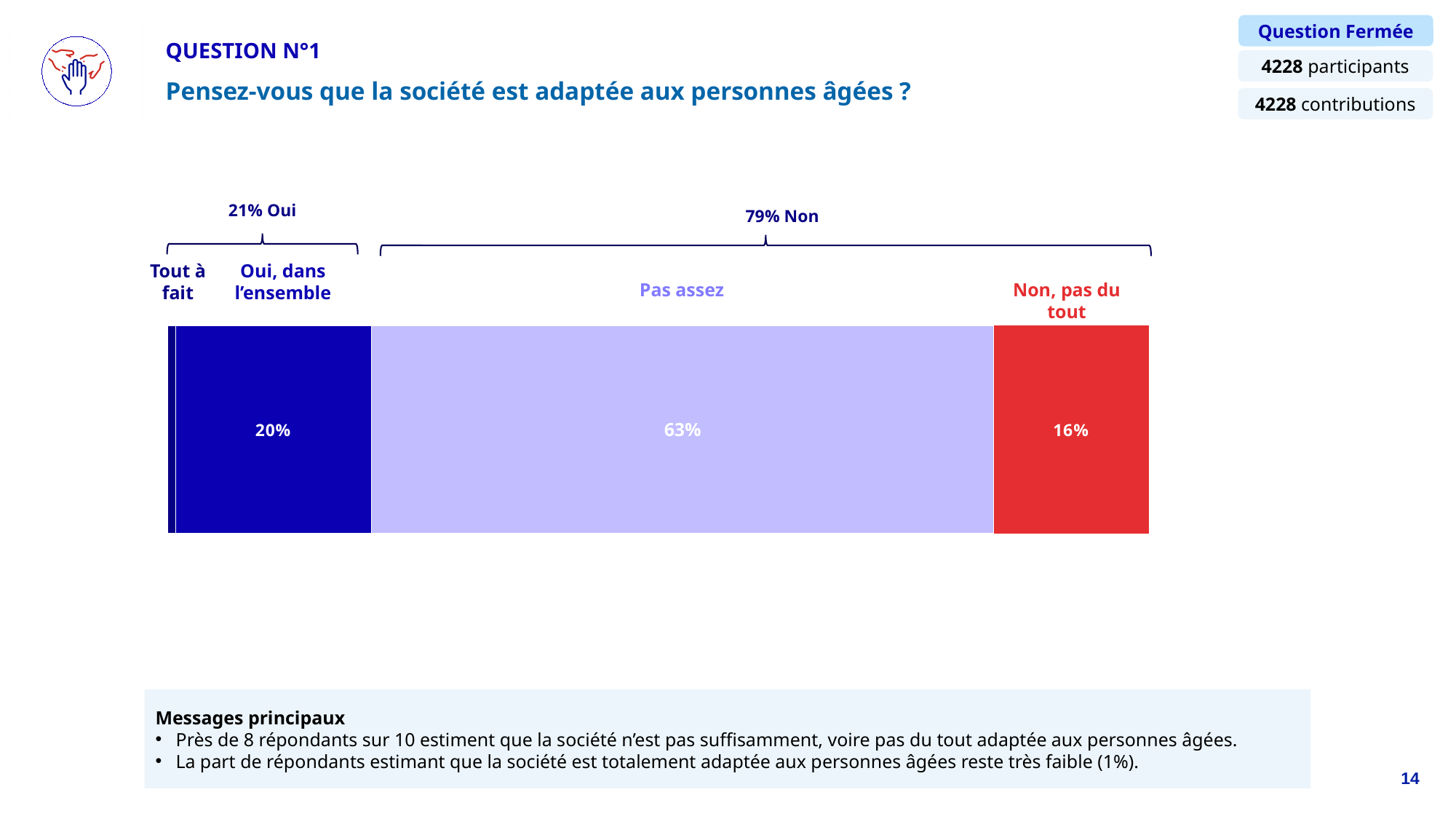
Which response category has the smallest share of respondents? Tout à fait Which is larger: the share for "Oui, dans l'ensemble" or the share for "Non, pas du tout"? Oui, dans l'ensemble How many response categories are shown in the bar? 4 What is the difference in percentage points between "Pas assez" and "Oui, dans l'ensemble"? 43 percentage points What is the combined share of respondents who answered "Non" (Pas assez plus Non, pas du tout)? 79% What colour is the "Non, pas du tout" segment of the bar? Red What percentage of respondents answered "Pas assez"? 63% What is the difference in percentage points between "Pas assez" and "Non, pas du tout"? 47 percentage points What percentage of respondents answered "Oui, dans l'ensemble"? 20% What kind of chart is shown on the slide? Stacked bar chart What percentage of respondents answered "Non, pas du tout"? 16% Which response category has the largest share of respondents? Pas assez